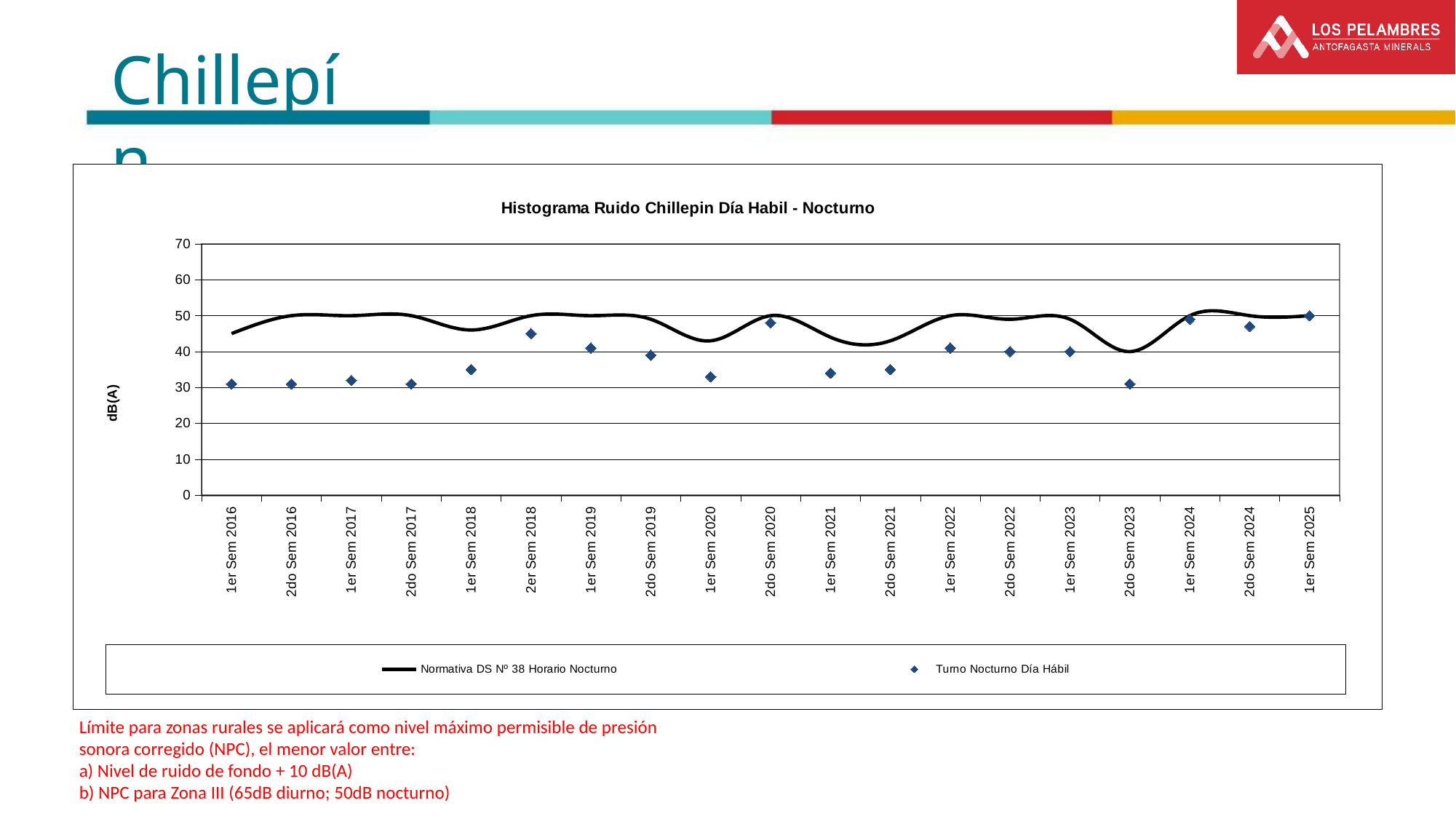
Is the Turno Nocturno Día Hábil value for 2er Sem 2018 greater or less than 40? greater Is the Turno Nocturno Día Hábil value for 1er Sem 2020 greater or less than 40? less What is the label of the y axis? dB(A) Is the Turno Nocturno Día Hábil value for 1er Sem 2024 greater or less than 40? greater How many series does the legend list? 2 Which has the higher Turno Nocturno Día Hábil value, 2do Sem 2020 or 1er Sem 2021? 2do Sem 2020 Which has the higher Turno Nocturno Día Hábil value, 1er Sem 2018 or 2er Sem 2018? 2er Sem 2018 What kind of chart is shown on the slide? line chart What is the title of the chart? Histograma Ruido Chillepin Día Habil - Nocturno How many categories are shown on the x axis? 19